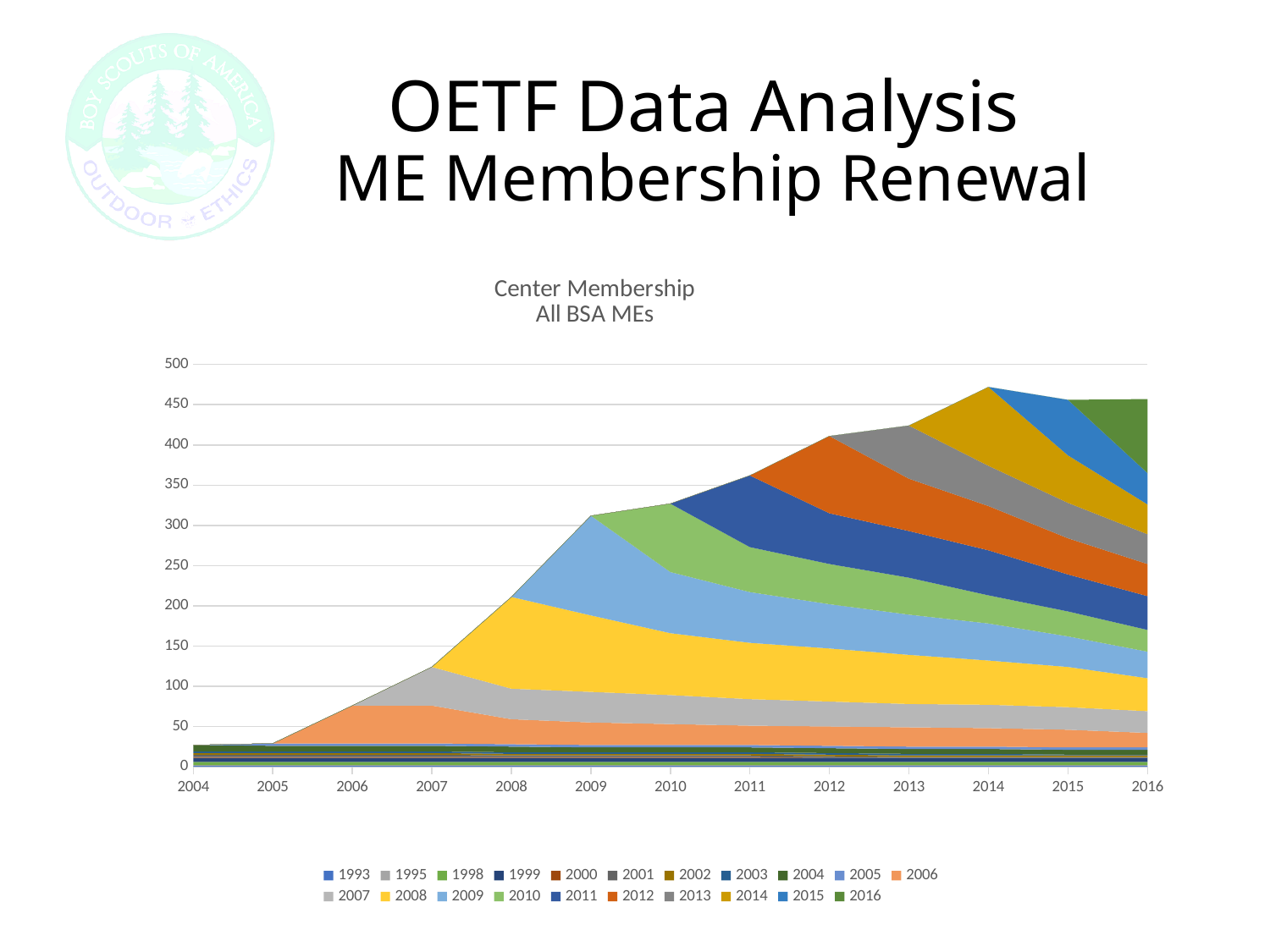
Is the total stacked value for 2004 greater or less than 50? less Is the total stacked value for 2014 greater or less than 450? greater How many years are shown along the x axis? 13 Is the total stacked value for 2008 greater or less than 150? greater Does the total stacked value generally rise or fall from 2004 to 2014? rise What is the title of the chart? Center Membership All BSA MEs How many series does the legend list? 21 What kind of chart is shown on the slide? Area chart Which is the first series listed in the legend? 1993